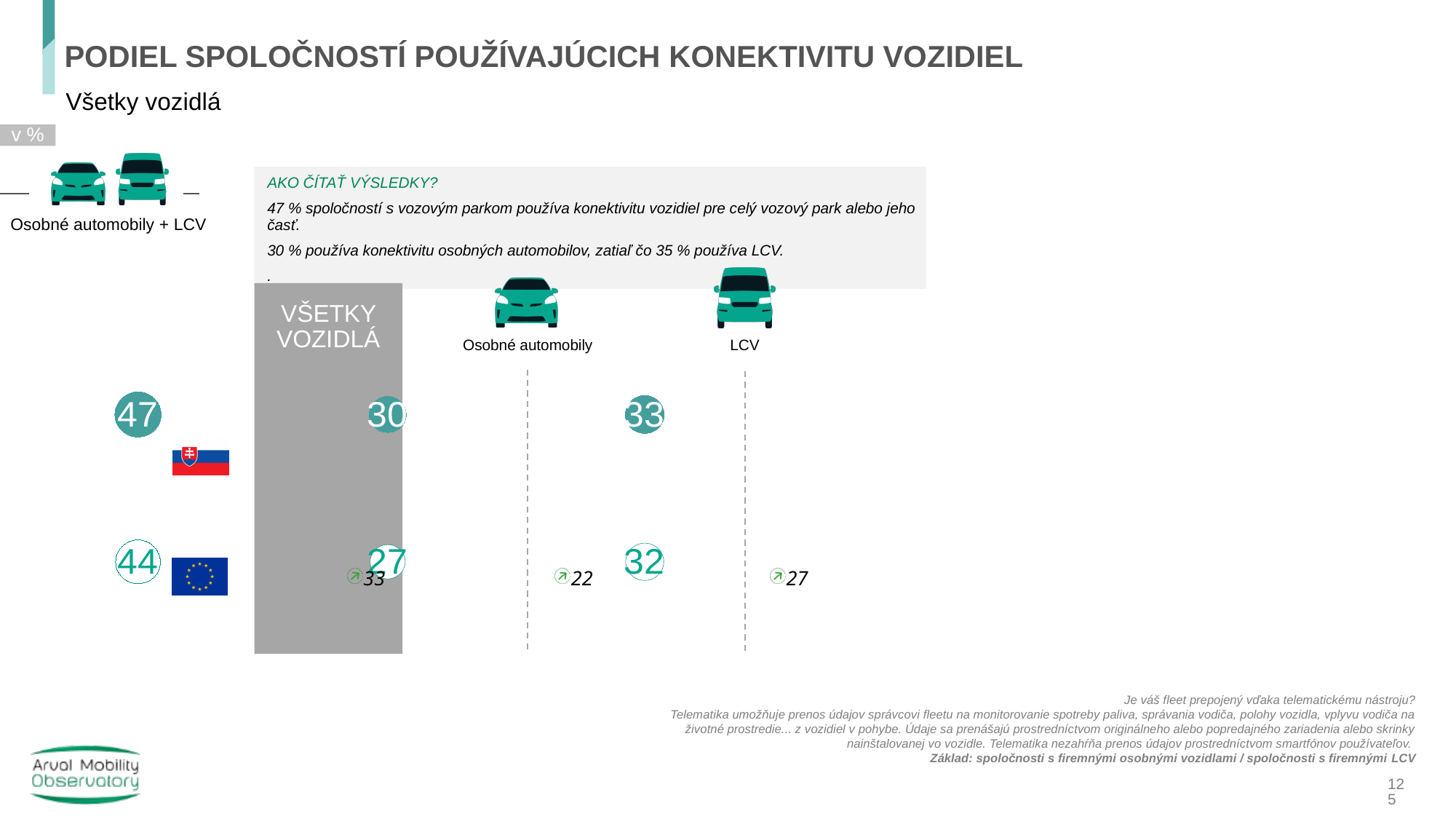
What is the difference between the Slovakia value (47) and the EU value (44) in the Osobné automobily + LCV column? 3 What number is shown in the green outlined circle inside the grey VŠETKY VOZIDLÁ column? 27 What unit are the values on the slide expressed in? % What value is shown for the EU (EU flag) in the Osobné automobily + LCV column? 44 How many country/region rows (flags) are shown on the chart? 2 What is the title of the slide? PODIEL SPOLOČNOSTÍ POUŽÍVAJÚCICH KONEKTIVITU VOZIDIEL What value is shown for Slovakia (Slovak flag) in the Osobné automobily + LCV column? 47 What number is shown in the teal circle inside the grey VŠETKY VOZIDLÁ column? 30 Which is larger in the Osobné automobily + LCV column: the Slovakia value or the EU value? Slovakia